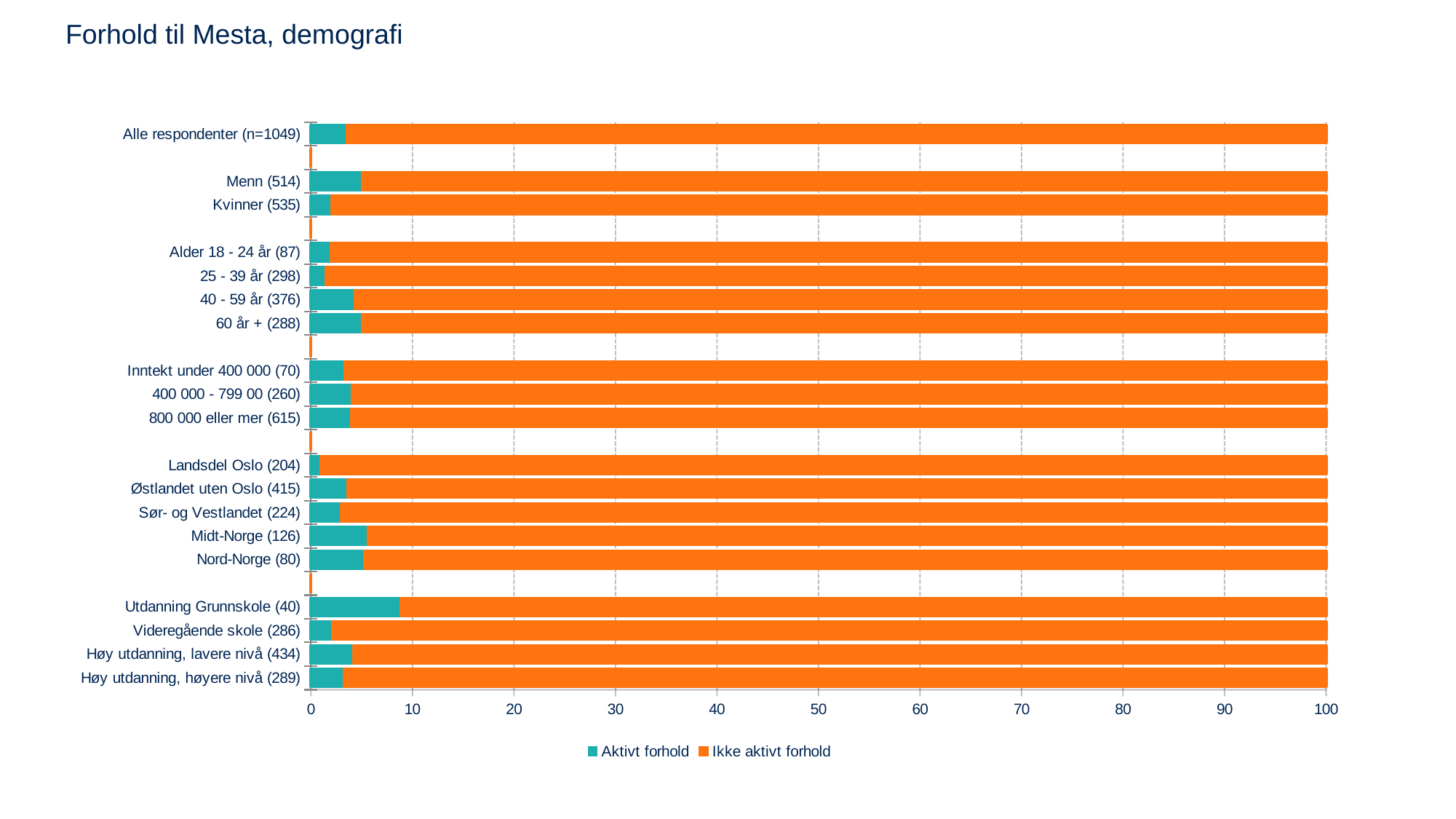
Which has a larger Aktivt forhold value, Midt-Norge (126) or Sør- og Vestlandet (224)? Midt-Norge (126) How many labeled categories are plotted on the chart? 19 Which category has the highest value for Aktivt forhold? Utdanning Grunnskole (40) Which has a larger Aktivt forhold value, Alder 18 - 24 år (87) or 60 år + (288)? 60 år + (288) Is the Aktivt forhold value for Utdanning Grunnskole (40) greater or less than 10? less Which category has the lowest value for Aktivt forhold? Landsdel Oslo (204) What are the two series named in the legend? Aktivt forhold, Ikke aktivt forhold Which has a larger Aktivt forhold value, Menn (514) or Kvinner (535)? Menn (514) What is the title of the chart? Forhold til Mesta, demografi How many series does the legend list? 2 What kind of chart is shown on the slide? Stacked bar chart Is the Ikke aktivt forhold value for Alle respondenter (n=1049) greater or less than 90? greater